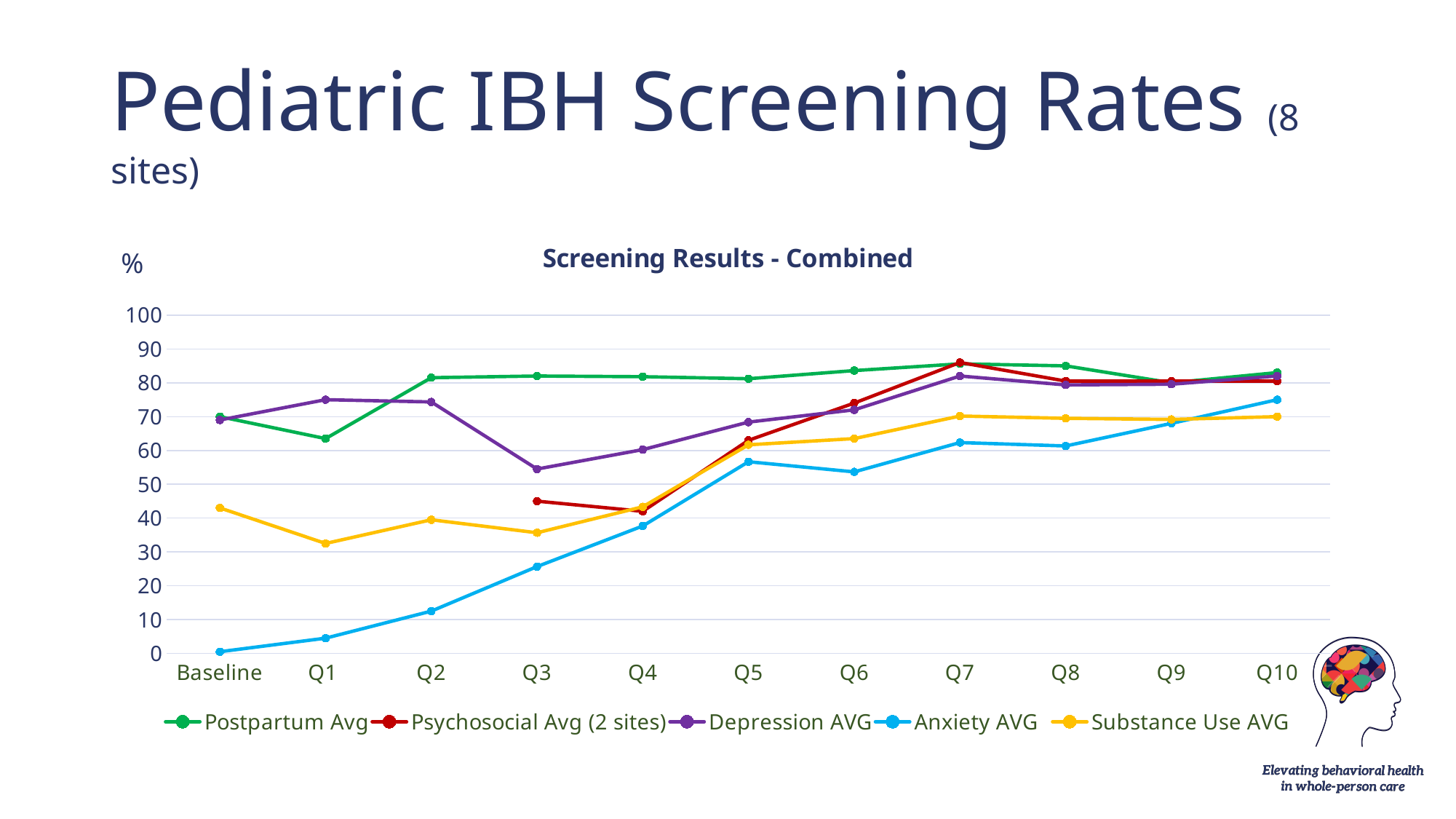
Is the value for Anxiety AVG at Q10 greater or less than 70? greater What is the title of the chart? Screening Results - Combined At which x-axis category does the Psychosocial Avg (2 sites) line begin? Q3 Is the value for Anxiety AVG at Q2 greater or less than 20? less What kind of chart is shown on the slide? line chart Is the value for Depression AVG at Q3 greater or less than 60? less How many categories are shown along the x axis? 11 Which series has the highest value at Q3? Postpartum Avg Does the Anxiety AVG line rise or fall from Baseline to Q7? rise How many series does the legend list? 5 Which series has the lowest value at Baseline? Anxiety AVG